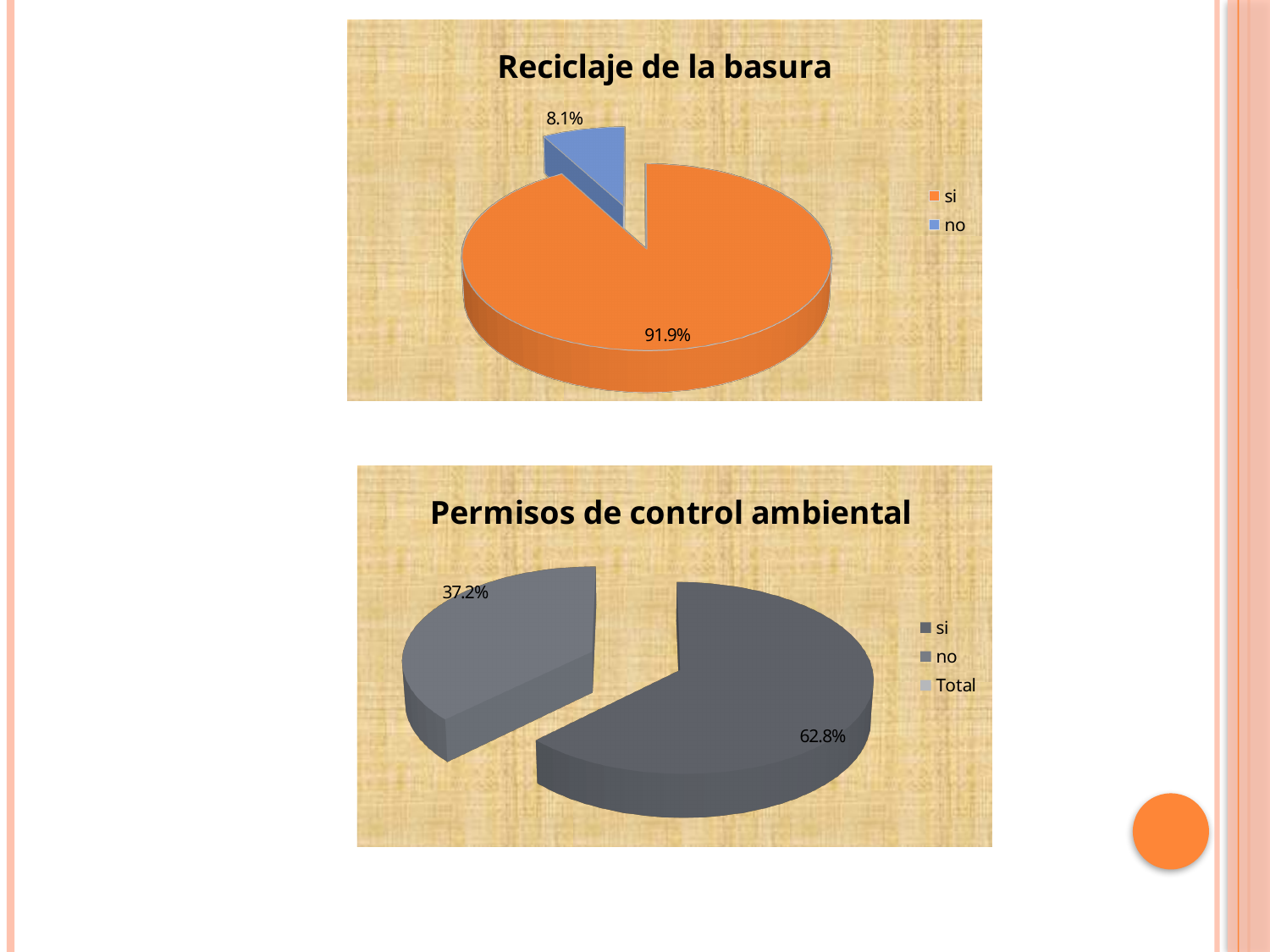
In the 'Reciclaje de la basura' chart, which category has the largest slice? si In the 'Reciclaje de la basura' chart, what percentage is shown for 'no'? 8.1% In the 'Permisos de control ambiental' chart, what percentage is shown for 'no'? 37.2% How many entries does the legend of the 'Reciclaje de la basura' chart list? 2 In the 'Permisos de control ambiental' chart, what is the difference between the 'si' and 'no' percentages? 25.6% In the 'Permisos de control ambiental' chart, what percentage is shown for 'si'? 62.8% In the 'Reciclaje de la basura' chart, what is the difference between the 'si' and 'no' percentages? 83.8% In the 'Permisos de control ambiental' chart, which category has the smallest slice? no How many entries does the legend of the 'Permisos de control ambiental' chart list? 3 In the 'Reciclaje de la basura' chart, what colour is the 'no' slice? Blue What kind of chart is 'Reciclaje de la basura'? Pie chart In the 'Reciclaje de la basura' chart, what percentage is shown for 'si'? 91.9%